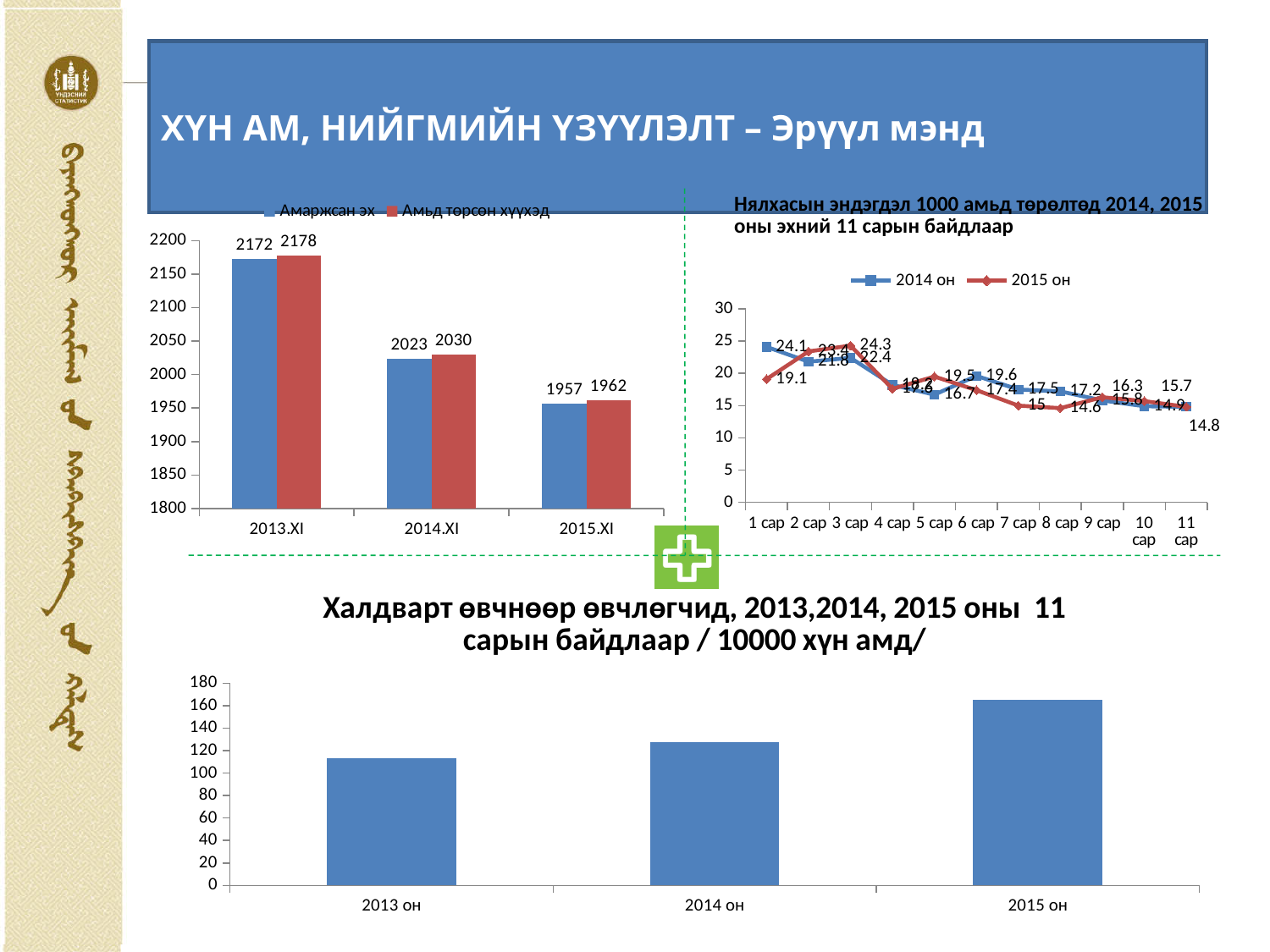
In the top-left bar chart, what is the value for Амьд төрсөн хүүхэд in 2015.XI? 1962 In the bottom chart titled 'Халдварт өвчнөөр өвчлөгчид', is the value for 2013 он greater or less than 120? less In the top-left bar chart, what is the value for Амаржсан эх in 2013.XI? 2172 In the chart titled 'Нялхасын эндэгдэл 1000 амьд төрөлтөд', what is the value for 2015 он in 1 сар? 19.1 In the top-left bar chart, which period has the lowest value for Амаржсан эх? 2015.XI In the top-left bar chart, do the values for Амаржсан эх rise or fall from 2013.XI to 2015.XI? fall In the bottom chart titled 'Халдварт өвчнөөр өвчлөгчид', which year has the highest value? 2015 он In the chart titled 'Нялхасын эндэгдэл 1000 амьд төрөлтөд', which series has the higher value in 1 сар, 2014 он or 2015 он? 2014 он In the top-left bar chart, what is the difference between Амьд төрсөн хүүхэд and Амаржсан эх in 2014.XI? 7 What kind of chart is the chart titled 'Нялхасын эндэгдэл 1000 амьд төрөлтөд'? line chart How many series does the legend of the top-left bar chart list? 2 In the chart titled 'Нялхасын эндэгдэл 1000 амьд төрөлтөд', what is the value for 2014 он in 1 сар? 24.1